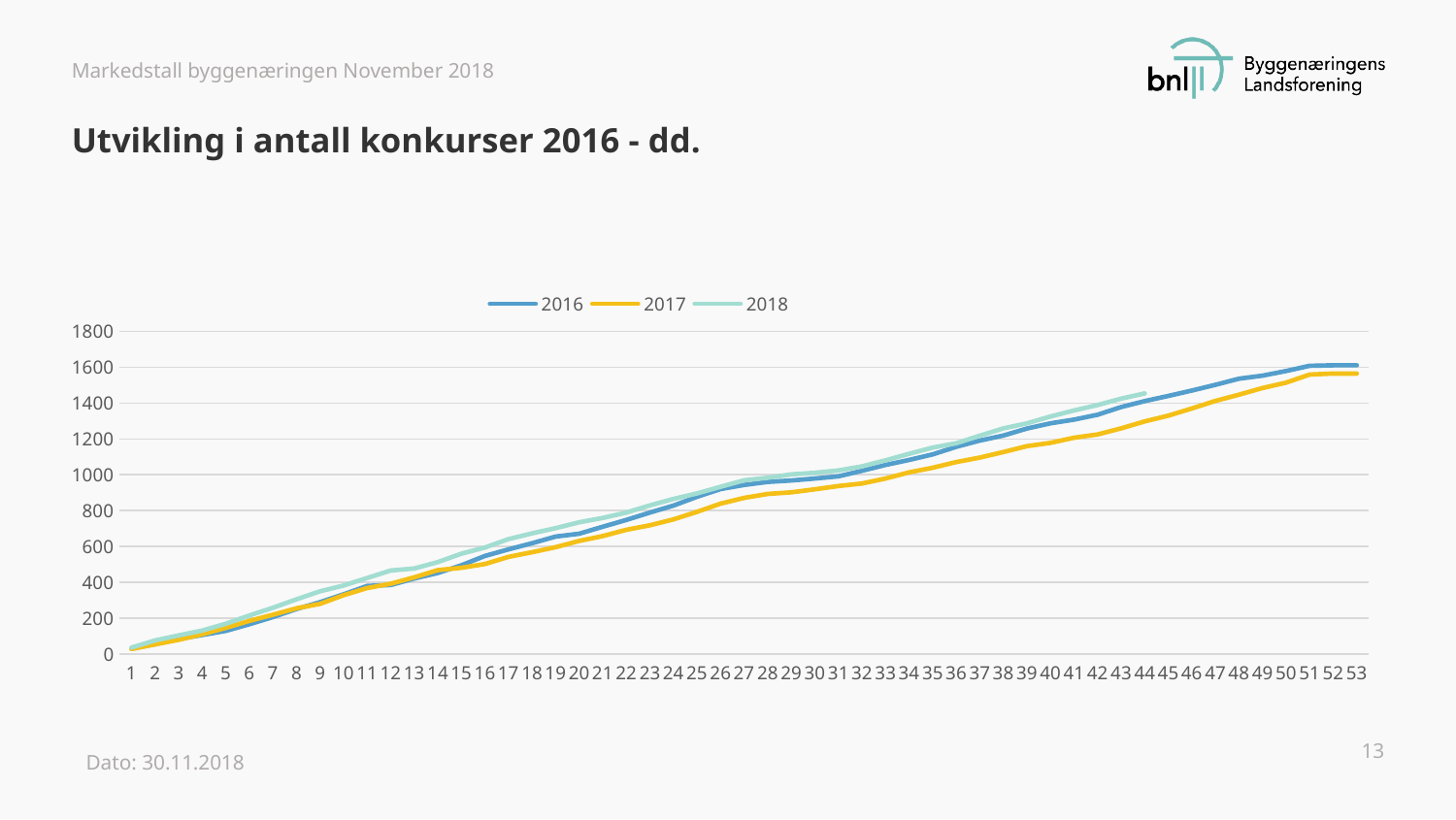
Which years are listed in the chart legend? 2016, 2017, 2018 What kind of chart is shown on the slide? line chart How many series does the legend list? 3 What is the title of the slide's chart section? Utvikling i antall konkurser 2016 - dd. Is the value for 2017 at point 10 greater or less than 600? less Do the values for the 2018 series rise or fall along the x axis? rise Do the values for the 2016 series rise or fall along the x axis? rise At point 44, which series is higher, 2018 or 2017? 2018 At point 53, which series is higher, 2016 or 2017? 2016 Is the value for 2016 at point 53 greater or less than 1400? greater Is the value for 2018 at point 44 greater or less than 1200? greater How many points are labelled on the x axis? 53